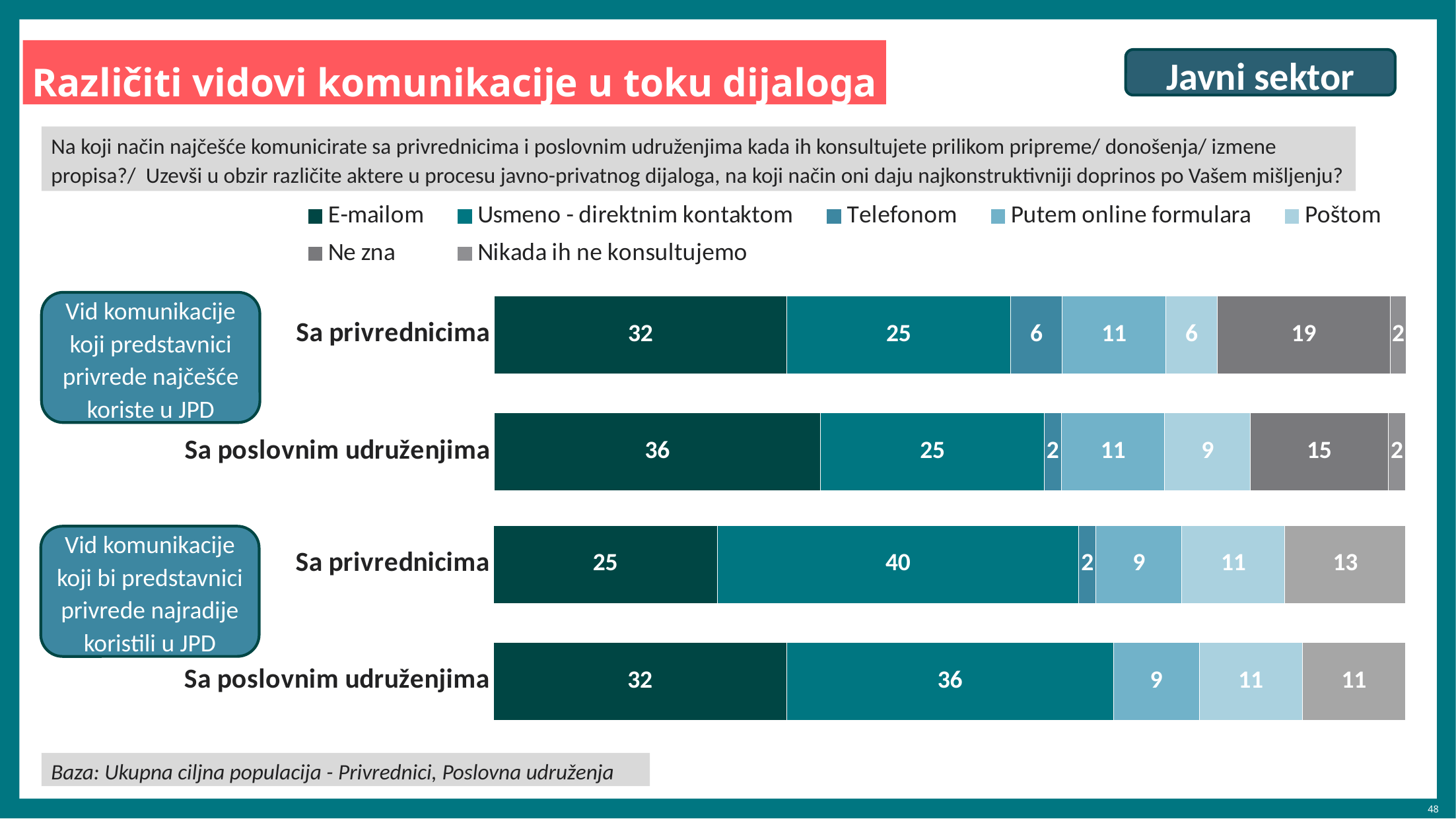
What kind of chart is shown on the slide? stacked bar chart In the bar for 'Sa poslovnim udruženjima' under 'Vid komunikacije koji predstavnici privrede najčešće koriste u JPD', what is the value for 'Ne zna'? 15 In the bar for 'Sa privrednicima' under 'Vid komunikacije koji bi predstavnici privrede najradije koristili u JPD', which series has the smallest value? Telefonom In the bar for 'Sa poslovnim udruženjima' under 'Vid komunikacije koji bi predstavnici privrede najradije koristili u JPD', what is the value for 'Poštom'? 11 In the 'najradije koristili' group, which is larger for 'Sa poslovnim udruženjima': 'E-mailom' or 'Usmeno - direktnim kontaktom'? Usmeno - direktnim kontaktom How many series does the legend list? 7 What is the total of the bar for 'Sa privrednicima' under 'Vid komunikacije koji bi predstavnici privrede najradije koristili u JPD'? 100 How many bars are plotted in the chart? 4 In the bar for 'Sa privrednicima' under 'Vid komunikacije koji predstavnici privrede najčešće koriste u JPD', which series has the largest value? E-mailom In the bar for 'Sa privrednicima' under 'Vid komunikacije koji bi predstavnici privrede najradije koristili u JPD', what is the value for 'Usmeno - direktnim kontaktom'? 40 In the bar for 'Sa privrednicima' under 'Vid komunikacije koji predstavnici privrede najčešće koriste u JPD', what is the value for 'E-mailom'? 32 What is the difference between the 'E-mailom' values for 'Sa poslovnim udruženjima' (36) and 'Sa privrednicima' (32) in the 'najčešće koriste' group? 4